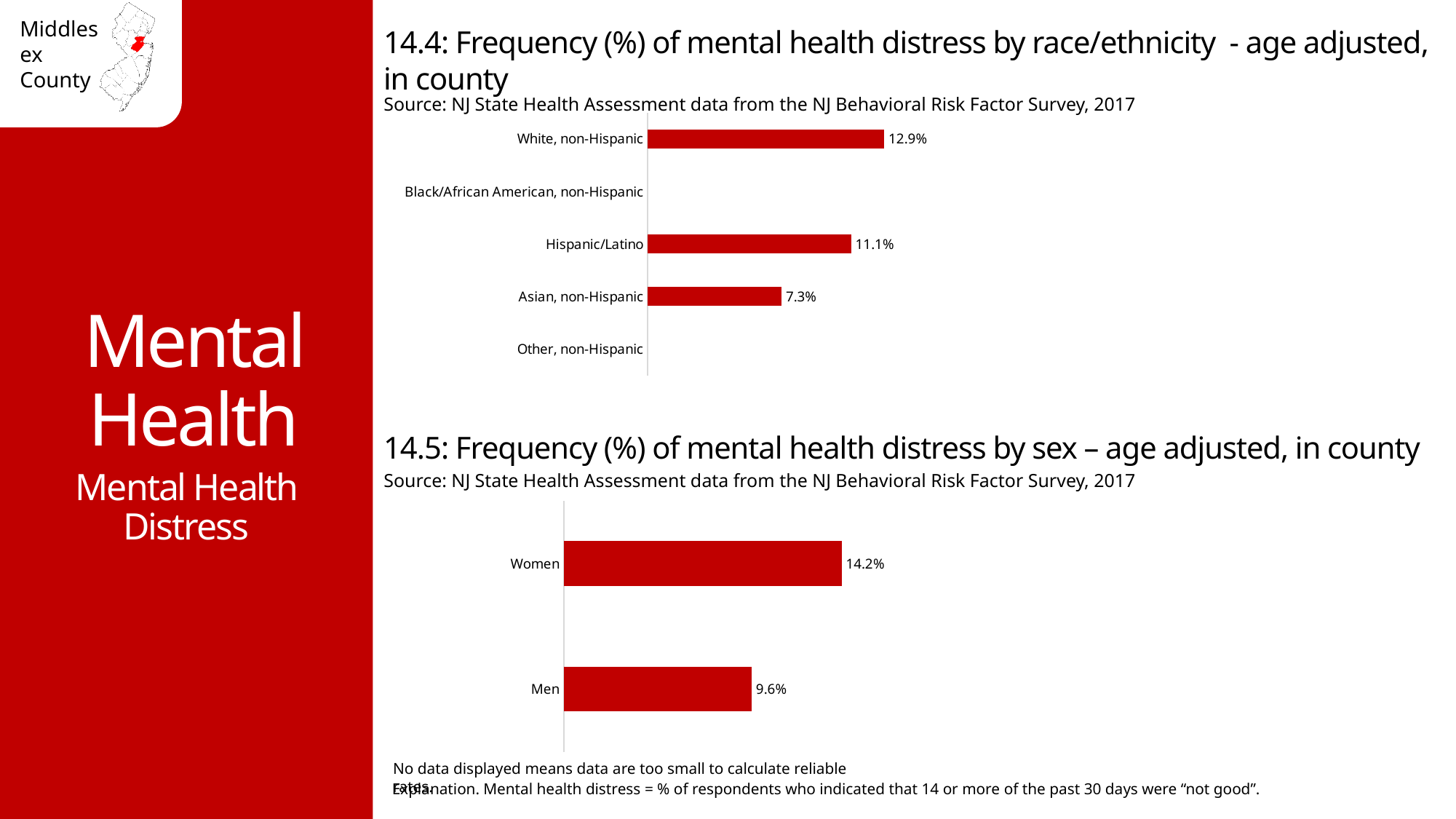
In chart 14.4 (mental health distress by race/ethnicity), which group with a displayed value has the highest frequency? White, non-Hispanic In chart 14.4 (mental health distress by race/ethnicity), what is the value for Asian, non-Hispanic? 7.3% In chart 14.4 (mental health distress by race/ethnicity), what is the difference between the White, non-Hispanic and Asian, non-Hispanic values? 5.6% In chart 14.5 (mental health distress by sex), what is the difference between the Women and Men values? 4.6% In chart 14.4 (mental health distress by race/ethnicity), how many race/ethnicity categories are listed on the axis? 5 In chart 14.5 (mental health distress by sex), what is the value for Women? 14.2% What type of chart is chart 14.5 (mental health distress by sex)? Bar chart In chart 14.4 (mental health distress by race/ethnicity), what is the value for Hispanic/Latino? 11.1% In chart 14.4 (mental health distress by race/ethnicity), which group with a displayed value has the lowest frequency? Asian, non-Hispanic In chart 14.4 (mental health distress by race/ethnicity), what is the value for White, non-Hispanic? 12.9% In chart 14.5 (mental health distress by sex), what is the value for Men? 9.6% In chart 14.4 (mental health distress by race/ethnicity), which categories have no bar displayed? Black/African American, non-Hispanic and Other, non-Hispanic